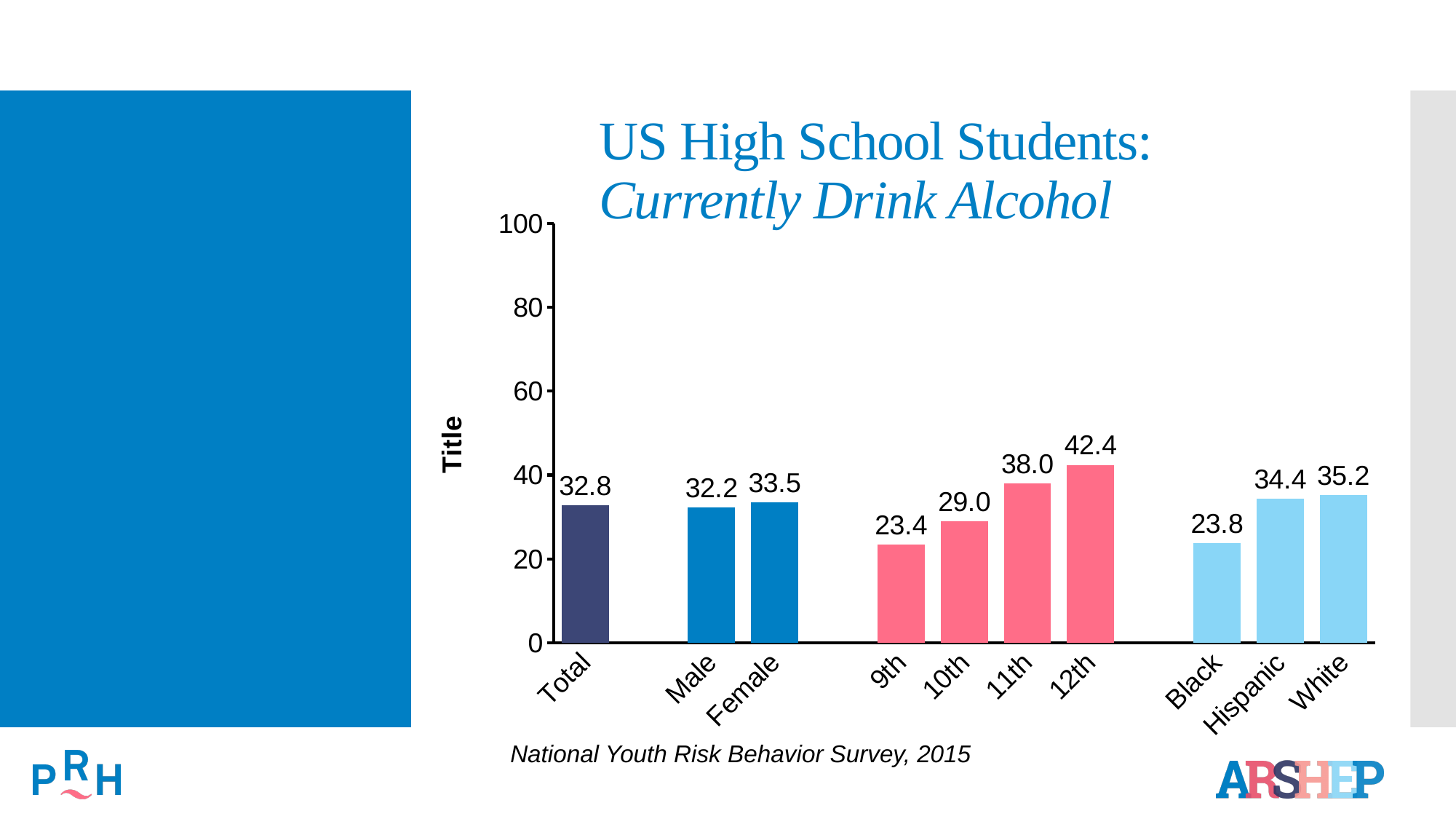
What is the difference between the Female and Male values? 1.3 What is the value for Hispanic students? 34.4 Which is larger, the value for White or the value for Black? White Is the value for 11th graders greater or less than 20? greater Do the values rise or fall from 9th grade to 12th grade? rise What is the value for Total? 32.8 How many bars are shown in the chart? 10 Which category has the highest value? 12th What is the value for 12th graders? 42.4 What is the difference between the 12th and 9th grade values? 19.0 Which category has the lowest value? 9th What kind of chart is shown? bar chart